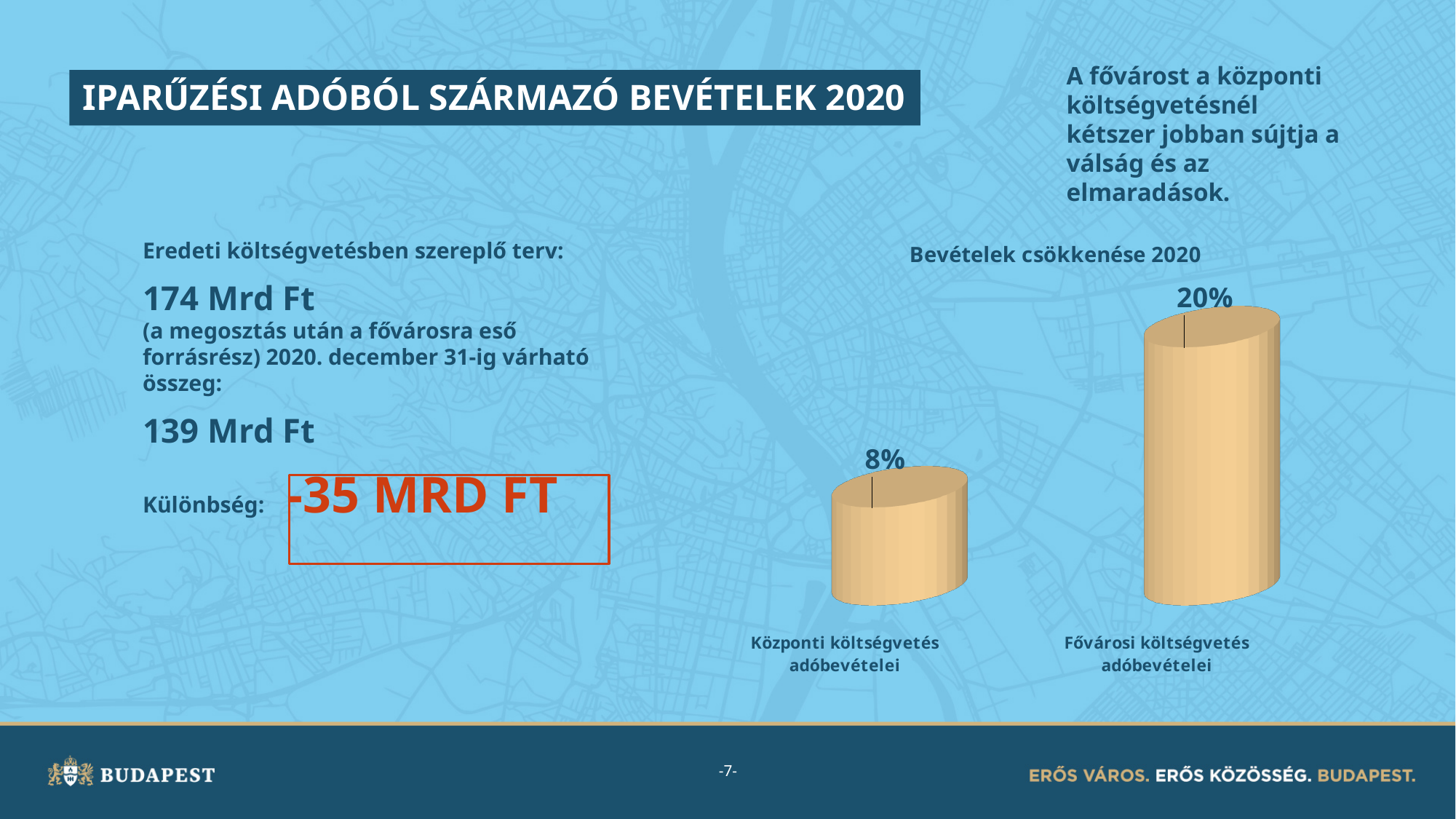
Do the values rise or fall from left to right in the Bevételek csökkenése 2020 chart? Rise Which category has the lowest value in the Bevételek csökkenése 2020 chart? Központi költségvetés adóbevételei What is the title of the chart on the slide? Bevételek csökkenése 2020 What is the value for Fővárosi költségvetés adóbevételei in the Bevételek csökkenése 2020 chart? 20% Which category has the highest value in the Bevételek csökkenése 2020 chart? Fővárosi költségvetés adóbevételei Which is larger in the chart: the value for Központi költségvetés adóbevételei or Fővárosi költségvetés adóbevételei? Fővárosi költségvetés adóbevételei What kind of chart is shown on the slide? Bar chart What is the value for Központi költségvetés adóbevételei in the Bevételek csökkenése 2020 chart? 8% What is the difference between the values for Fővárosi költségvetés adóbevételei and Központi költségvetés adóbevételei in the chart? 12% How many categories are shown in the Bevételek csökkenése 2020 chart? 2 What colour are the bars in the Bevételek csökkenése 2020 chart? Beige/tan